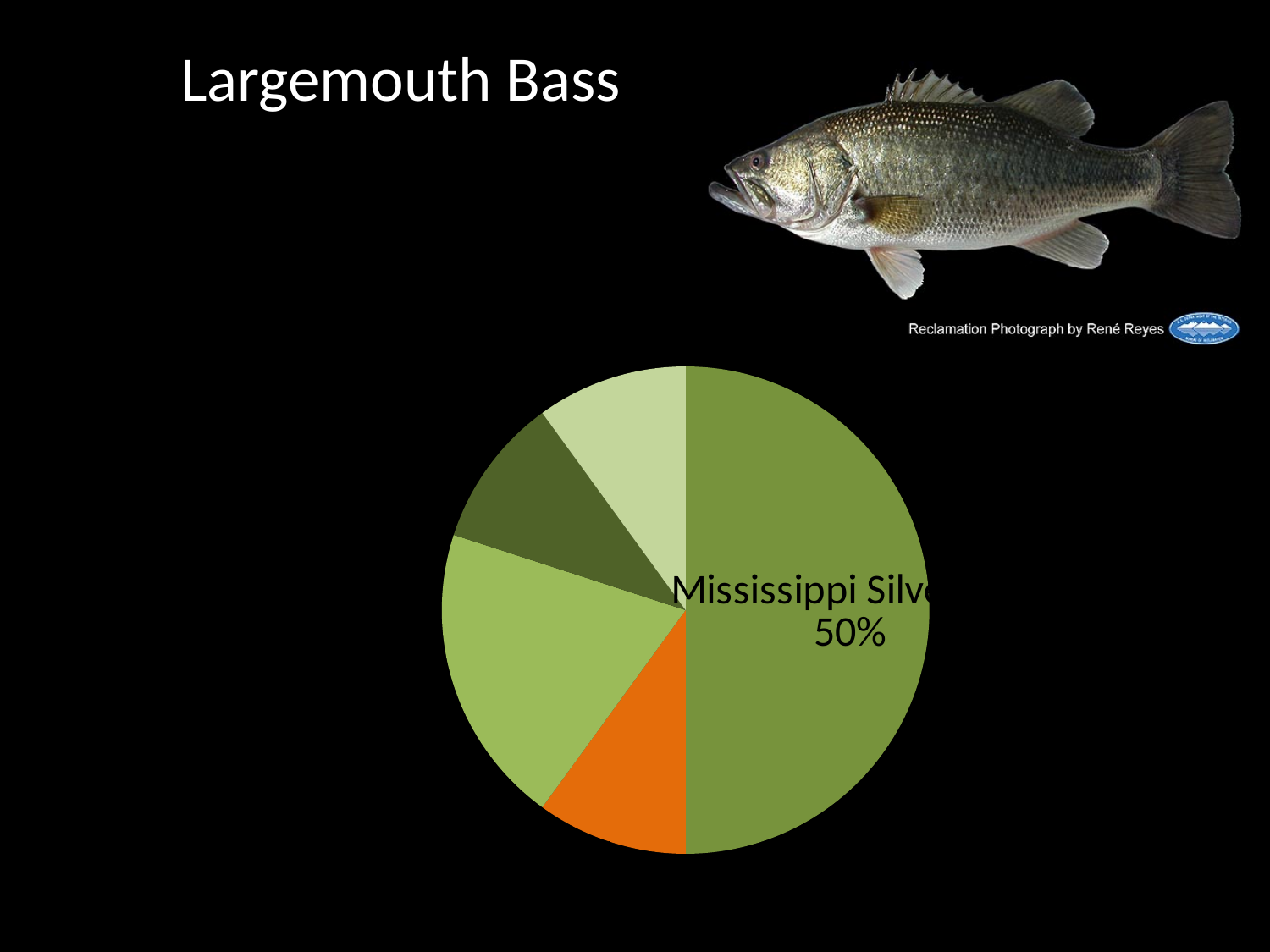
What is the title of the slide containing the pie chart? Largemouth Bass What share of the pie does the largest slice have? 50% What kind of chart is shown on the slide? pie chart Is the orange slice larger or smaller than the slice labelled 50%? smaller What colour is the largest slice of the pie chart? green How many slices does the pie chart have? 5 What percentage is printed on the pie chart? 50%